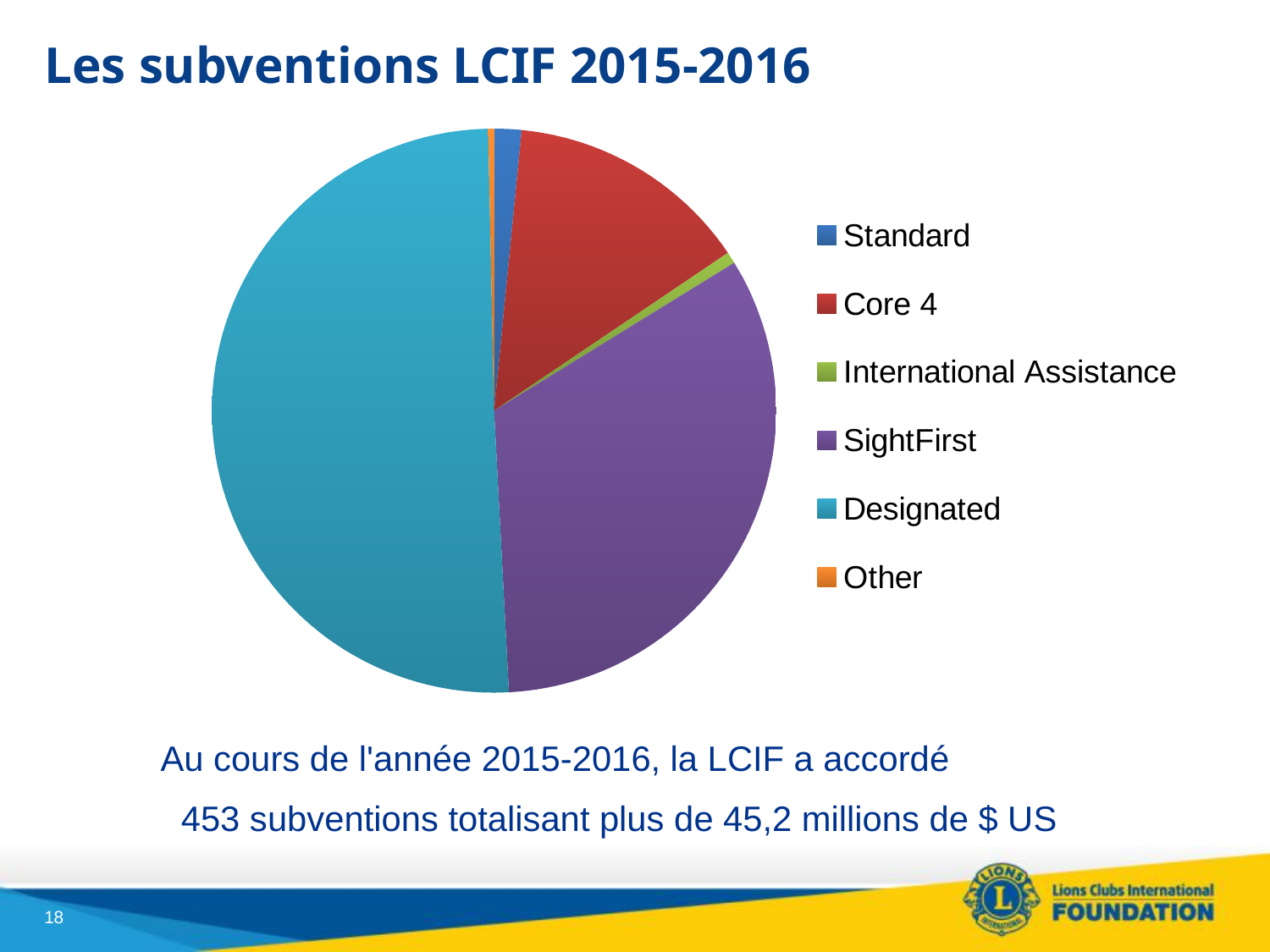
How many categories does the pie chart show? 6 Which category has the largest slice of the pie chart? Designated Which slice is larger, SightFirst or Core 4? SightFirst Which legend entry is listed last in the pie chart's legend? Other Which slice is larger, Standard or International Assistance? Standard Which slice is larger, Core 4 or Standard? Core 4 Which category is the second largest slice of the pie chart? SightFirst What kind of chart is shown on the slide? Pie chart What colour is the Core 4 slice in the pie chart? Red What is the title of the slide containing the pie chart? Les subventions LCIF 2015-2016